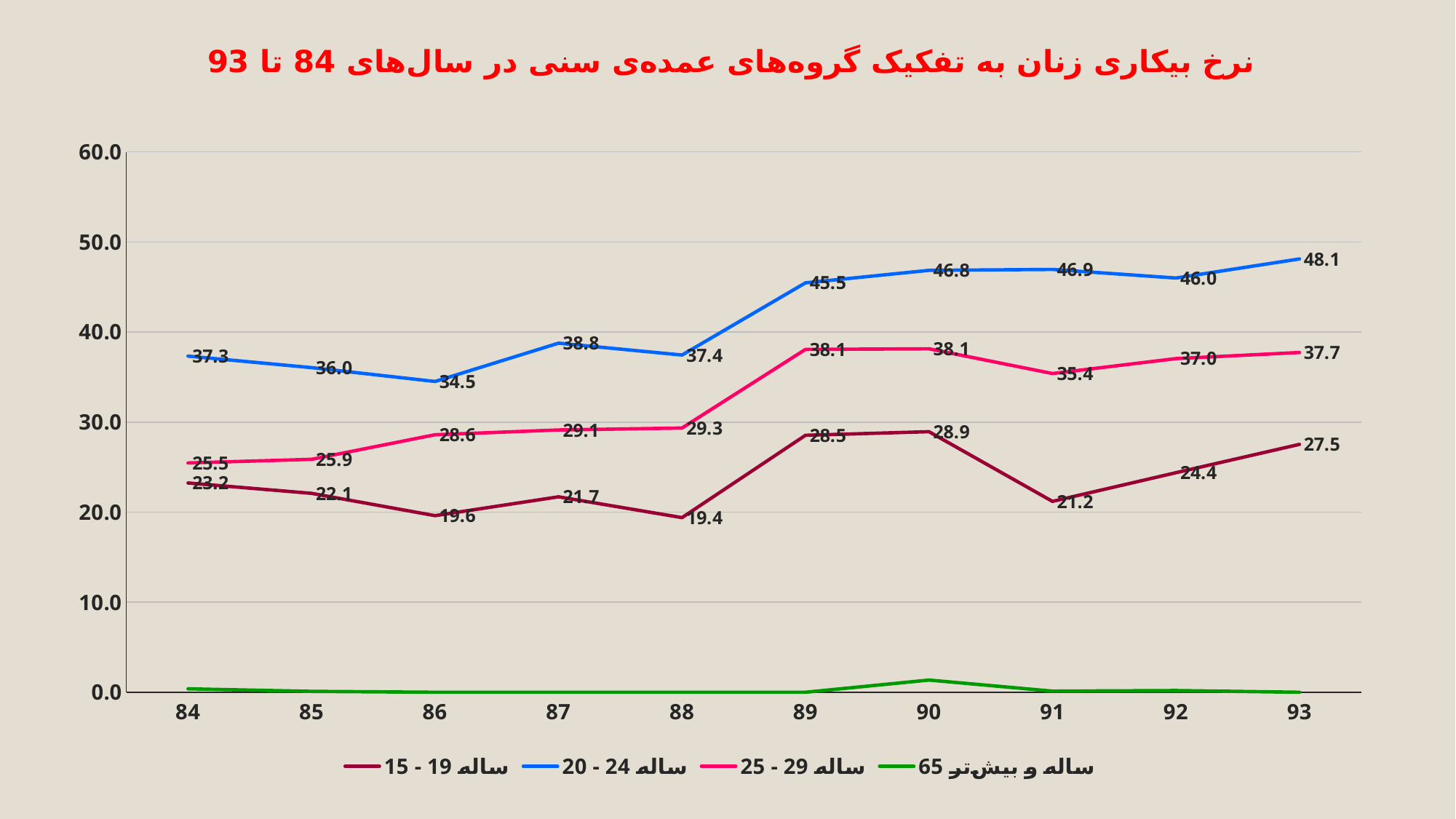
How many series does the legend list? 4 What is the value for the 20 - 24 ساله series in year 93? 48.1 What is the difference between the 20 - 24 ساله value and the 25 - 29 ساله value in year 89? 7.4 What is the value for the 15 - 19 ساله series in year 88? 19.4 In which year does the 15 - 19 ساله series have its lowest value? 88 In which year does the 20 - 24 ساله series reach its highest value? 93 Which series has the higher value in year 90: 15 - 19 ساله or 25 - 29 ساله? 25 - 29 ساله Is the value for the 65 ساله و بیش‌تر series in year 90 greater or less than 10.0? less Does the 20 - 24 ساله series rise or fall between year 88 and year 89? rise How many years are shown along the x axis? 10 What type of chart is shown on the slide? line chart What is the value for the 25 - 29 ساله series in year 91? 35.4